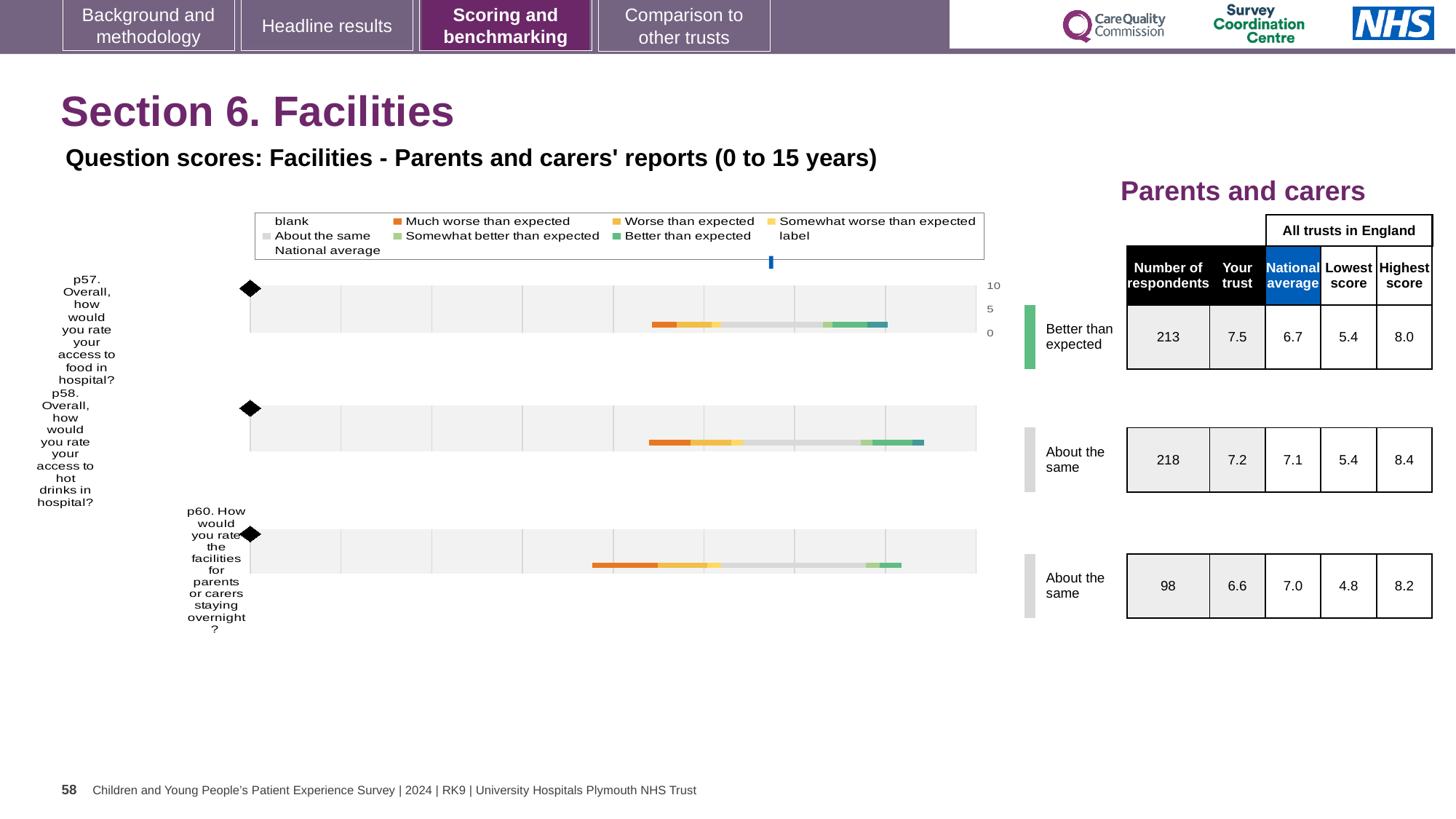
For the p60 chart (facilities for parents or carers staying overnight), how many respondents are shown in the table? 98 For the p58 chart (access to hot drinks in hospital), what is the national average shown in the table? 7.1 What kind of chart is used for the question scores on this slide? bar chart What is the highest value shown on the chart's axis? 10 How many question rows (charts) are plotted on the slide? 3 Which of the three question charts has the highest number of respondents in the table? p58. Overall, how would you rate your access to hot drinks in hospital? Which of the three question charts has the lowest 'Your trust' score in the table? p60. How would you rate the facilities for parents or carers staying overnight? Which legend entry is shown in dark orange? Much worse than expected For the p57 chart (access to food in hospital), what is the 'Your trust' score shown in the table? 7.5 For the p57 chart (access to food in hospital), what is the difference between the highest score and the lowest score in the table? 2.6 For the p60 chart (facilities for parents or carers staying overnight), which is larger: the 'Your trust' score or the national average? National average For the p58 chart (access to hot drinks in hospital), which is larger: the 'Your trust' score or the national average? Your trust